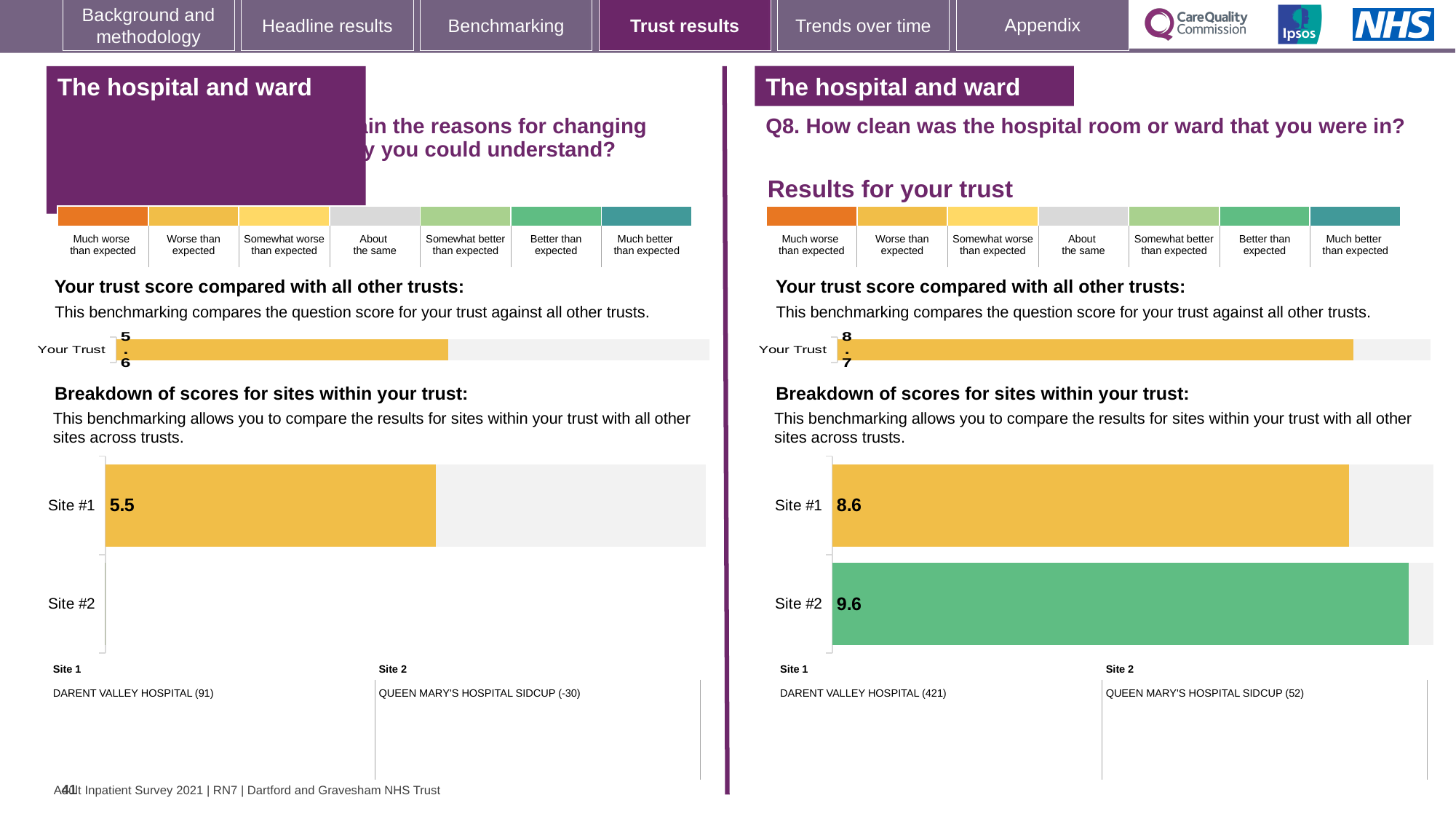
On the right-hand slide (Q8, how clean was the hospital room or ward), what is the score for Site #2 in the breakdown of scores for sites? 9.6 On the right-hand slide (Q8), what is the 'Your Trust' score shown in the trust benchmarking bar? 8.7 On the right-hand slide (Q8), what is the difference between the Site #2 score and the Site #1 score? 1.0 On the right-hand slide (Q8), which hospital is listed as Site 1? DARENT VALLEY HOSPITAL (421) On the right-hand slide (Q8), how many sites are shown in the breakdown of scores chart? 2 On the right-hand slide (Q8, how clean was the hospital room or ward), what is the score for Site #1 in the breakdown of scores for sites? 8.6 On the left-hand slide, what is the 'Your Trust' score shown in the trust benchmarking bar? 5.6 On the left-hand slide, what is the score for Site #1 in the breakdown of scores for sites? 5.5 On the right-hand slide (Q8), what colour is the bar for Site #2? Green What kind of chart is used for the breakdown of scores for sites on the right-hand slide (Q8)? Bar chart On the right-hand slide (Q8), which site has the higher score, Site #1 or Site #2? Site #2